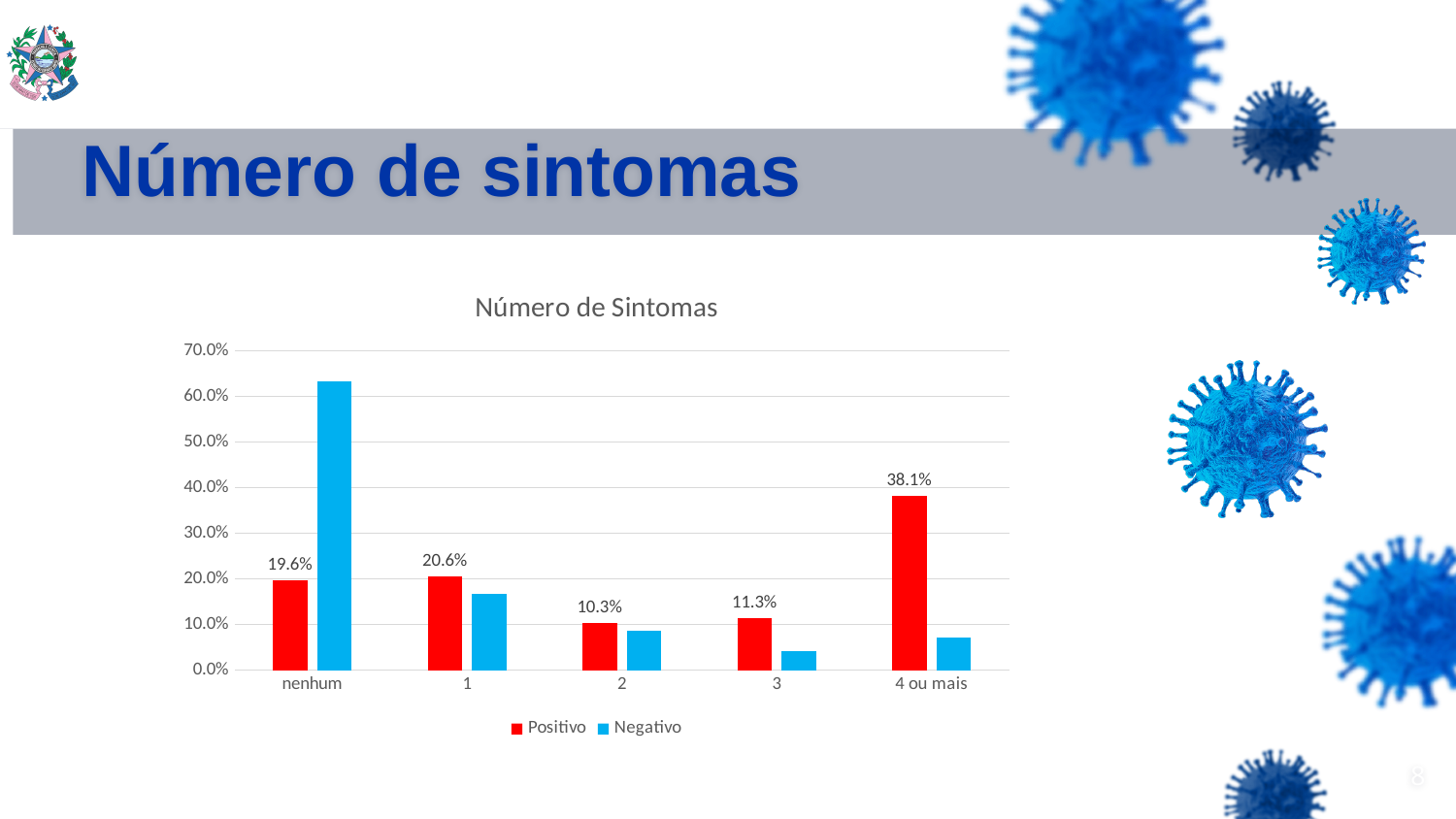
What type of chart is shown on the slide? Bar chart What is the difference between the Positivo values for '4 ou mais' and '1'? 17.5% Which is larger for the 'nenhum' category, the Positivo bar or the Negativo bar? Negativo What is the Positivo value for the '4 ou mais' category? 38.1% What is the Positivo value for the 'nenhum' category? 19.6% Is the Negativo value for '3' greater or less than 10.0%? less How many categories are shown on the x axis? 5 How many series does the legend list? 2 Which category has the lowest Positivo value? 2 Is the Negativo value for 'nenhum' greater or less than 60.0%? greater What is the Positivo value for category '2'? 10.3% Which category has the highest Positivo value? 4 ou mais